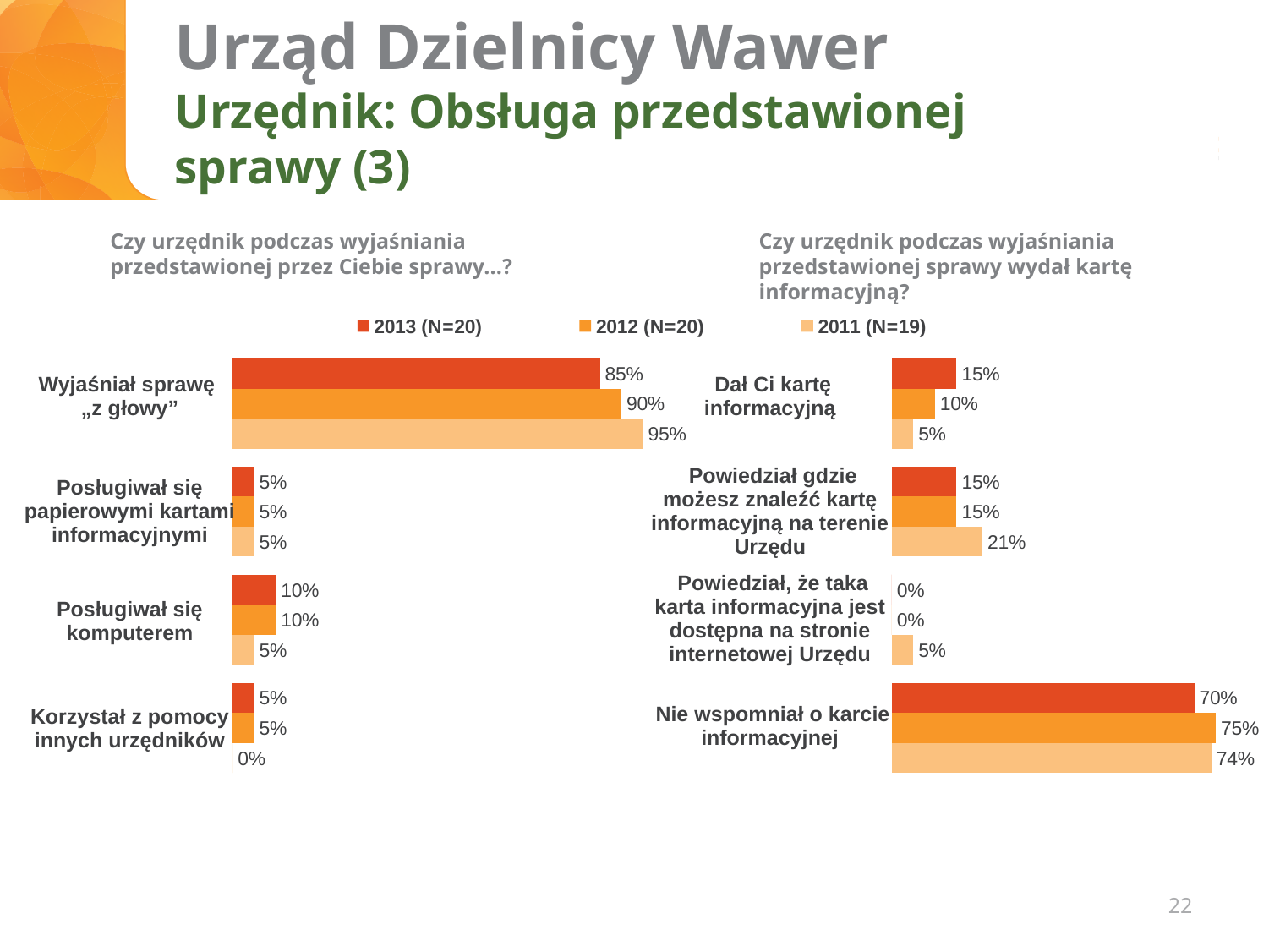
In the right chart, which is larger for "Dał Ci kartę informacyjną": the 2013 value or the 2011 value? 2013 In the left chart, what is the 2011 value for "Korzystał z pomocy innych urzędników"? 0% In the left chart, which category has the highest 2012 value? Wyjaśniał sprawę „z głowy” What kind of chart is the left chart? Bar chart How many series does the legend list? 3 In the right chart ("Czy urzędnik podczas wyjaśniania przedstawionej sprawy wydał kartę informacyjną?"), what is the 2011 value for "Powiedział gdzie możesz znaleźć kartę informacyjną na terenie Urzędu"? 21% In the left chart, what is the 2011 value for "Posługiwał się komputerem"? 5% In the left chart, what is the difference between the 2011 and 2013 values for "Wyjaśniał sprawę „z głowy”"? 10 percentage points In the right chart, which category has the lowest 2013 value? Powiedział, że taka karta informacyjna jest dostępna na stronie internetowej Urzędu In the left chart ("Czy urzędnik podczas wyjaśniania przedstawionej przez Ciebie sprawy...?"), what is the 2013 value for "Wyjaśniał sprawę „z głowy”"? 85% In the right chart, what is the difference between the 2012 and 2013 values for "Nie wspomniał o karcie informacyjnej"? 5 percentage points In the right chart, what is the 2012 value for "Nie wspomniał o karcie informacyjnej"? 75%